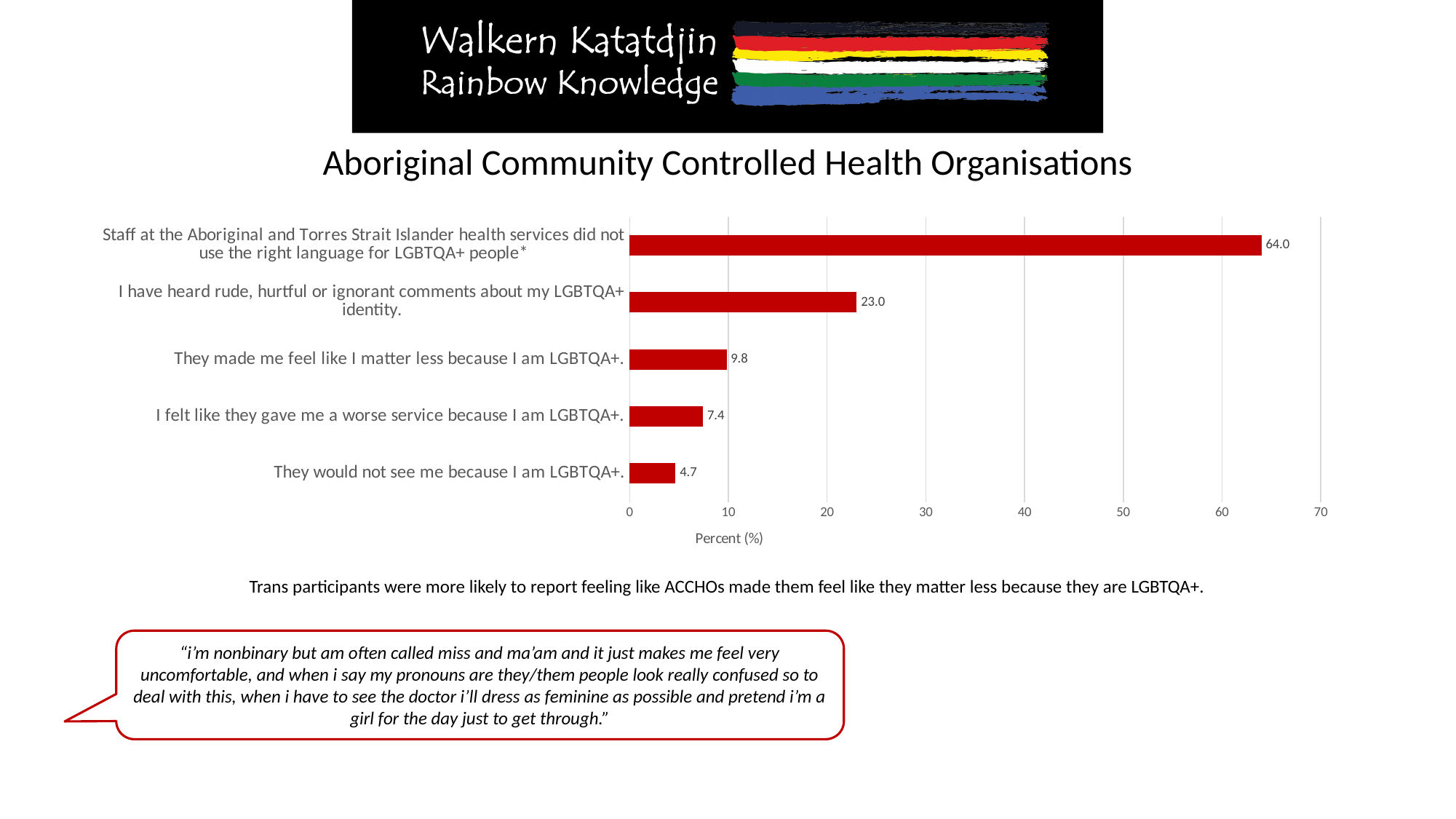
How many categories are shown in the chart? 5 Which category has the highest value? Staff at the Aboriginal and Torres Strait Islander health services did not use the right language for LGBTQA+ people* Which is larger: the value for "I have heard rude, hurtful or ignorant comments about my LGBTQA+ identity." or the value for "They made me feel like I matter less because I am LGBTQA+."? I have heard rude, hurtful or ignorant comments about my LGBTQA+ identity. What is the difference between the highest and lowest values in the chart? 59.3 What is the difference between the value for "They made me feel like I matter less because I am LGBTQA+." and the value for "I felt like they gave me a worse service because I am LGBTQA+."? 2.4 Which category has the lowest value? They would not see me because I am LGBTQA+. What is the value for "I felt like they gave me a worse service because I am LGBTQA+."? 7.4 What is the label of the horizontal axis? Percent (%) What percentage of participants reported that staff at the Aboriginal and Torres Strait Islander health services did not use the right language for LGBTQA+ people? 64.0 What kind of chart is shown on the slide? Bar chart What is the value for "They would not see me because I am LGBTQA+."? 4.7 What is the value for "I have heard rude, hurtful or ignorant comments about my LGBTQA+ identity."? 23.0